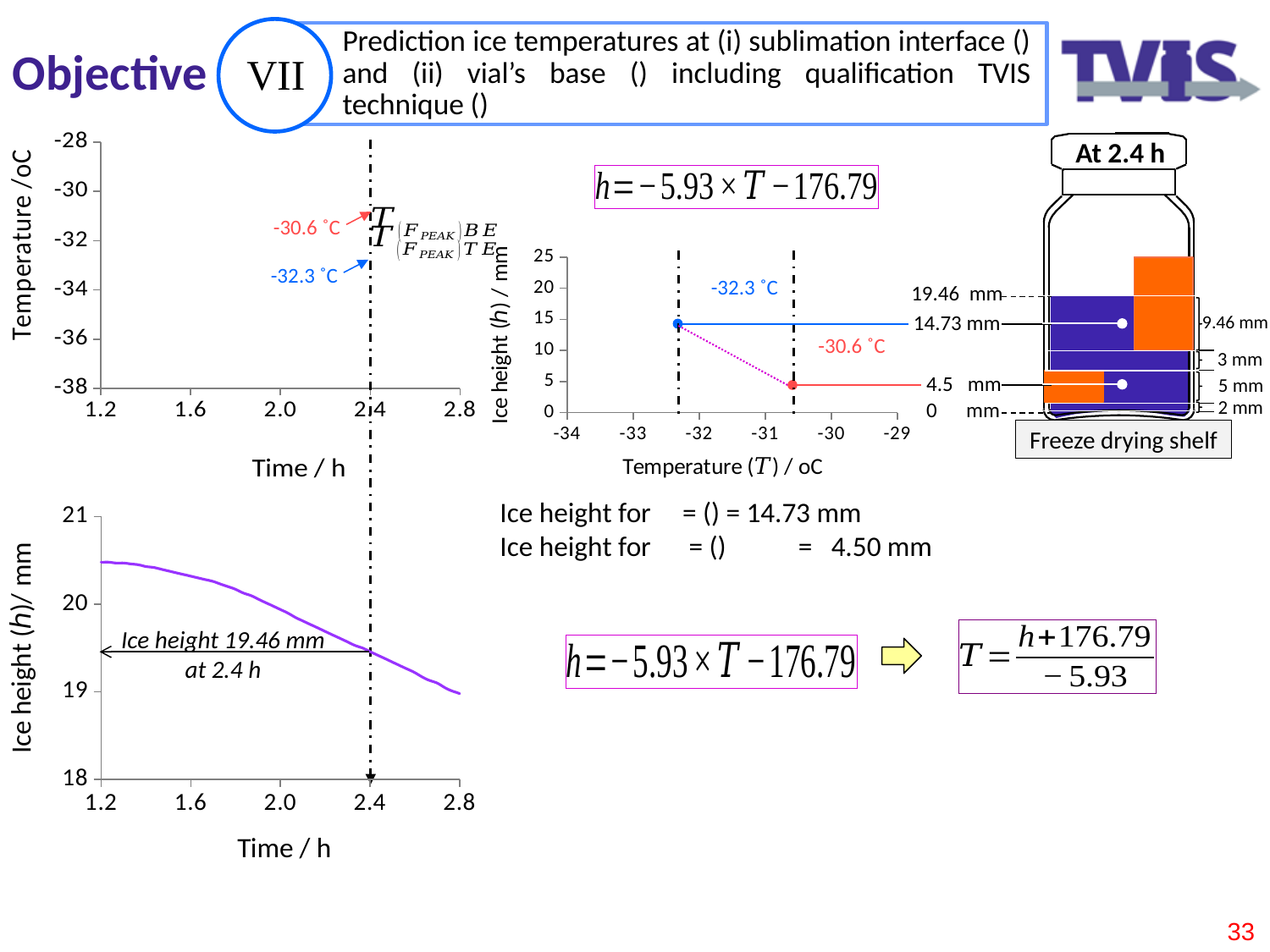
What is the x-axis label of the bottom-left chart? Time / h What kind of chart is the bottom-left chart of ice height against time? line chart In the top-left temperature chart, which two temperatures are annotated at 2.4 h? -30.6 °C and -32.3 °C In the middle chart of ice height against temperature, what is the difference between the ice heights at -32.3 °C and -30.6 °C? 10.23 mm In the bottom-left chart, what ice height is annotated at 2.4 h? 19.46 mm In the bottom-left chart, does the ice height rise or fall as time increases from 1.2 h to 2.8 h? fall In the middle chart of ice height against temperature, which temperature has the larger ice height, -32.3 °C or -30.6 °C? -32.3 °C In the middle chart of ice height against temperature, what is the ice height at -32.3 °C? 14.73 mm In the bottom-left chart, is the ice height at 1.2 h greater or less than 20? greater How many data points are plotted in the middle chart of ice height against temperature? 2 What equation is shown above the middle chart of ice height against temperature? h = -5.93 × T - 176.79 In the middle chart of ice height against temperature, what is the ice height at -30.6 °C? 4.5 mm